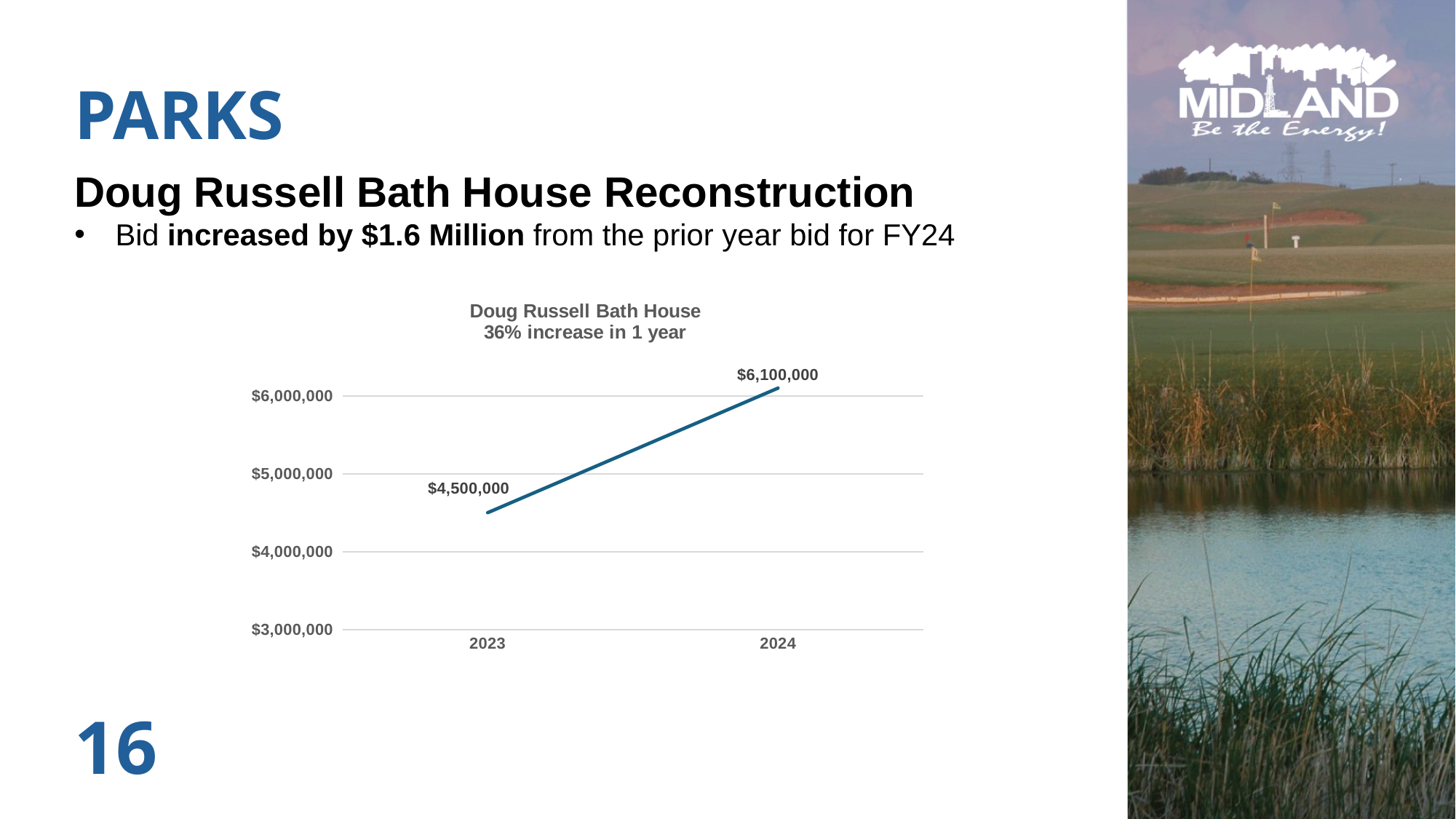
What is the difference between the 2024 and 2023 values? $1,600,000 Is the value for 2024 greater or less than $6,000,000? greater What kind of chart is shown? Line chart Is the value for 2023 greater or less than $5,000,000? less Is the value for 2024 larger than the value for 2023? Yes What is the value for 2024? $6,100,000 What is the title of the chart? Doug Russell Bath House 36% increase in 1 year What is the value for 2023? $4,500,000 Which year has the lower value? 2023 Do the values rise or fall from 2023 to 2024? Rise How many data points are plotted on the chart? 2 Which year has the higher value? 2024